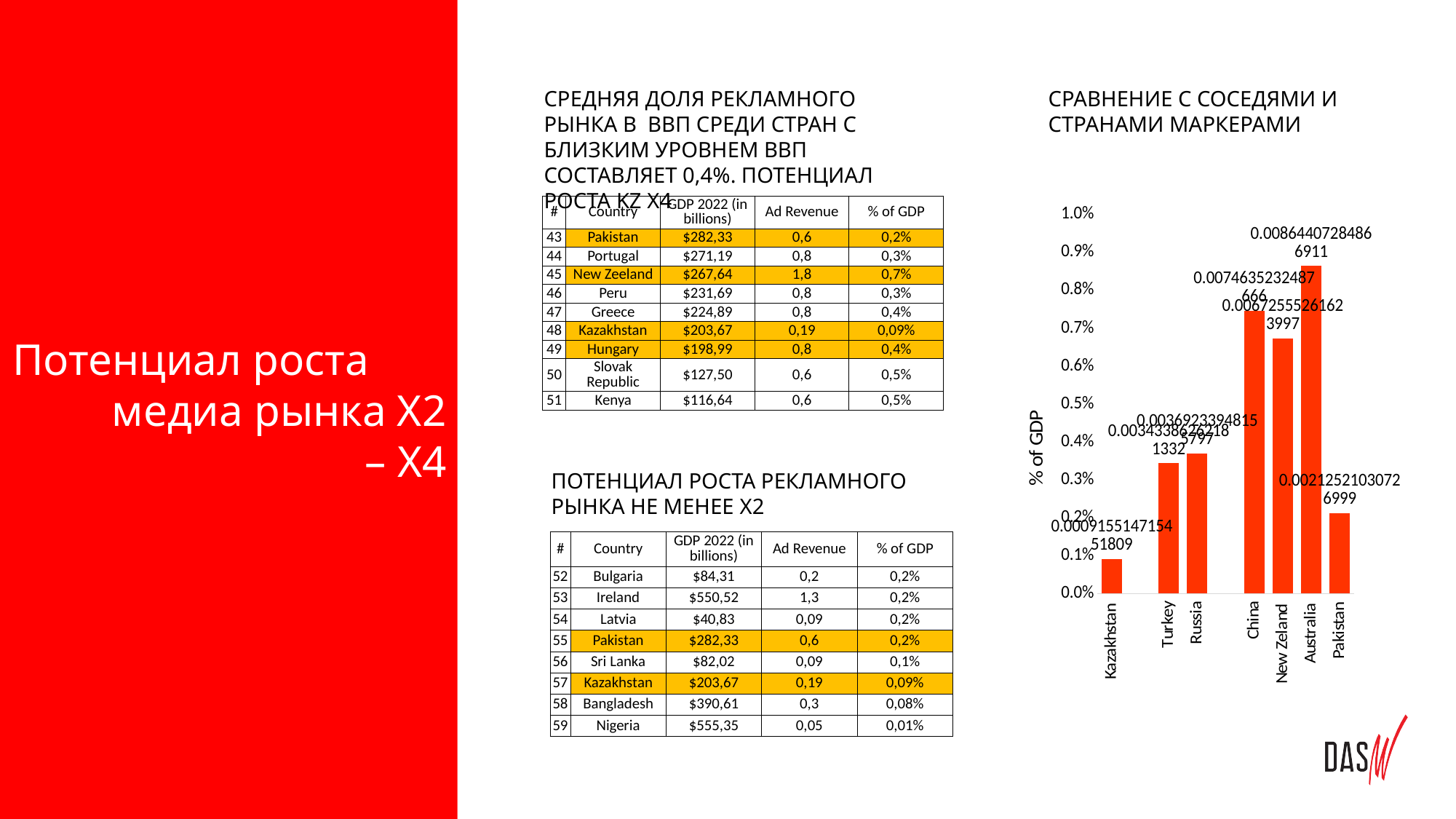
Is the value for China in the bar chart greater or less than 0.7%? greater What kind of chart is shown under the title 'СРАВНЕНИЕ С СОСЕДЯМИ И СТРАНАМИ МАРКЕРАМИ'? Bar chart Is the value for Pakistan in the bar chart greater or less than 0.3%? less In the bar chart, which is larger, the value for Pakistan or the value for Kazakhstan? Pakistan Which country has the lowest bar in the chart? Kazakhstan In the bar chart, which is larger, the value for China or the value for New Zeland? China Which country has the highest bar in the chart? Australia Is the value for Australia in the bar chart greater or less than 0.8%? greater What is the label on the vertical axis of the bar chart? % of GDP How many countries are plotted in the bar chart? 7